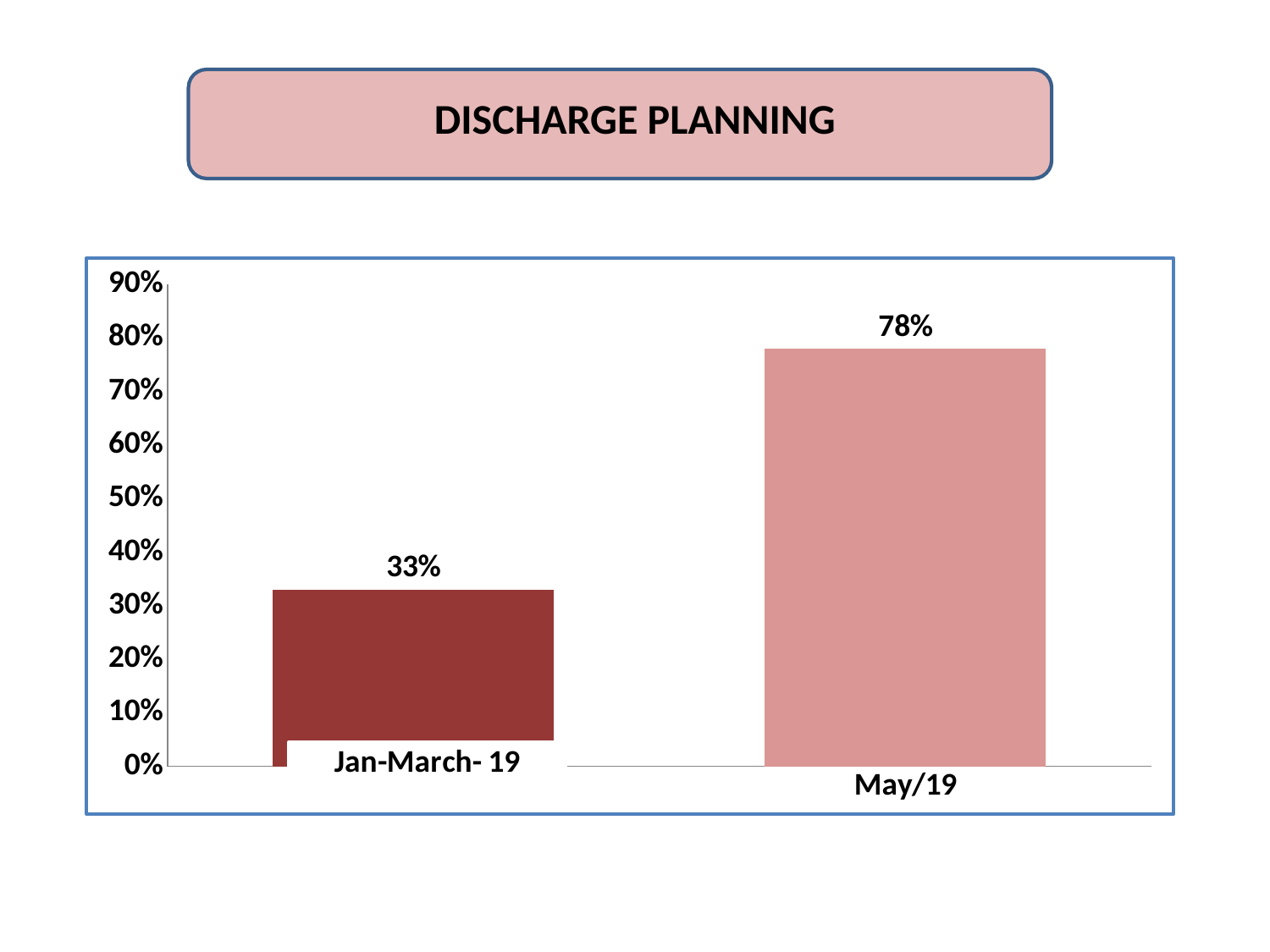
What kind of chart is shown on the slide? Bar chart Which category has the lowest value? Jan-March- 19 What is the value for May/19? 78% What is the value for Jan-March- 19? 33% How many categories are shown in the chart? 2 What is the difference between the values for May/19 and Jan-March- 19? 45% What is the title shown above the chart? DISCHARGE PLANNING Do the values rise or fall from Jan-March- 19 to May/19? Rise Is the value for May/19 greater or less than 70%? greater Which is larger, the value for Jan-March- 19 or the value for May/19? May/19 Which category has the highest value? May/19 Is the value for Jan-March- 19 greater or less than 40%? less